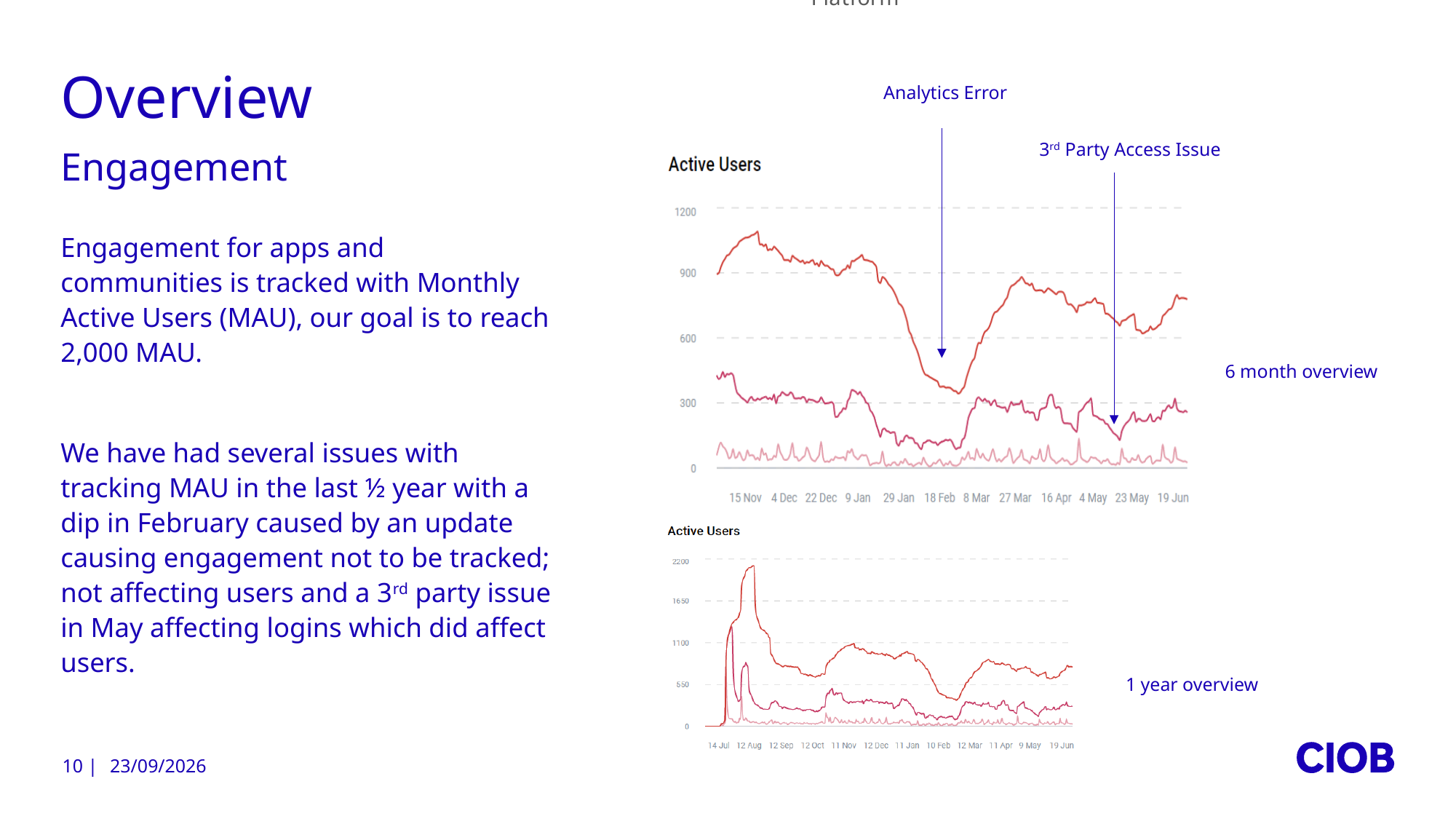
What is the title of the 6 month overview chart? Active Users What kind of chart is the 6 month overview chart? line chart How many date labels are shown on the x axis of the 6 month overview chart? 12 What kind of chart is the 1 year overview chart? line chart What is the highest value shown on the y axis of the 1 year overview chart? 2200 On the 6 month overview chart, does the top line rise or fall between 15 Nov and 18 Feb? fall How many lines are plotted on the 6 month overview chart? 3 On the 6 month overview chart, is the value of the top line at 18 Feb greater or less than 600? less On the 1 year overview chart, is the peak of the top line near 12 Aug greater or less than 1650? greater On the 6 month overview chart, does the top line rise or fall between 18 Feb and 27 Mar? rise On the 1 year overview chart, is the value of the top line at 19 Jun greater or less than 1100? less